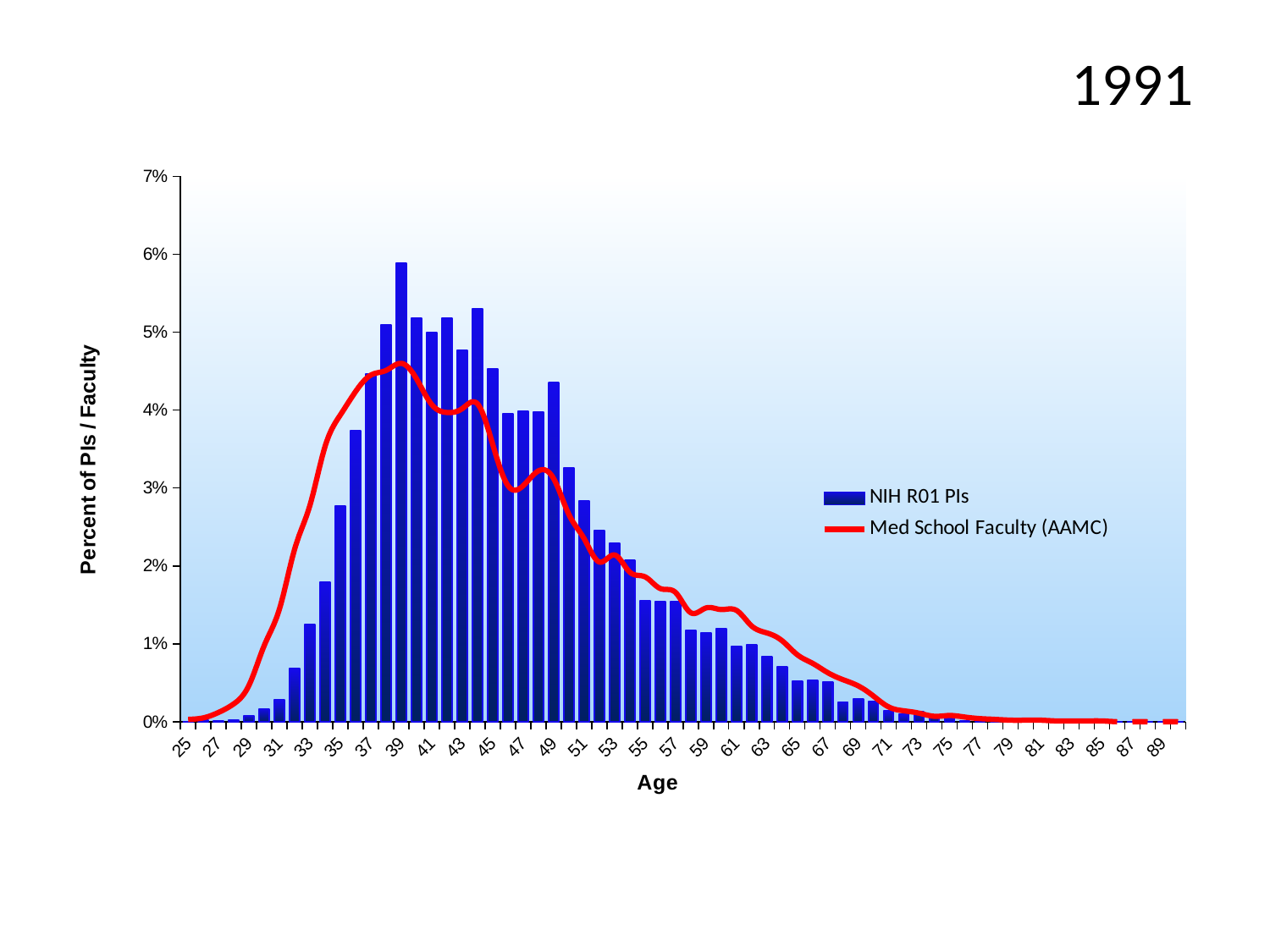
Which is larger at age 33: the NIH R01 PIs bar or the Med School Faculty (AAMC) line? Med School Faculty (AAMC) Which is larger at age 39: the NIH R01 PIs bar or the Med School Faculty (AAMC) line? NIH R01 PIs What is the title of the y axis? Percent of PIs / Faculty At which age is the NIH R01 PIs bar highest? 39 Is the NIH R01 PIs value at age 65 greater or less than 1%? less What kind of chart is shown on the slide? A bar chart with a line overlay What are the two series named in the legend? NIH R01 PIs and Med School Faculty (AAMC) Do the NIH R01 PIs bars generally rise or fall from age 49 to age 69? fall Is the NIH R01 PIs value at age 39 greater or less than 5%? greater Is the NIH R01 PIs value at age 35 greater or less than 3%? less How many series does the legend list? 2